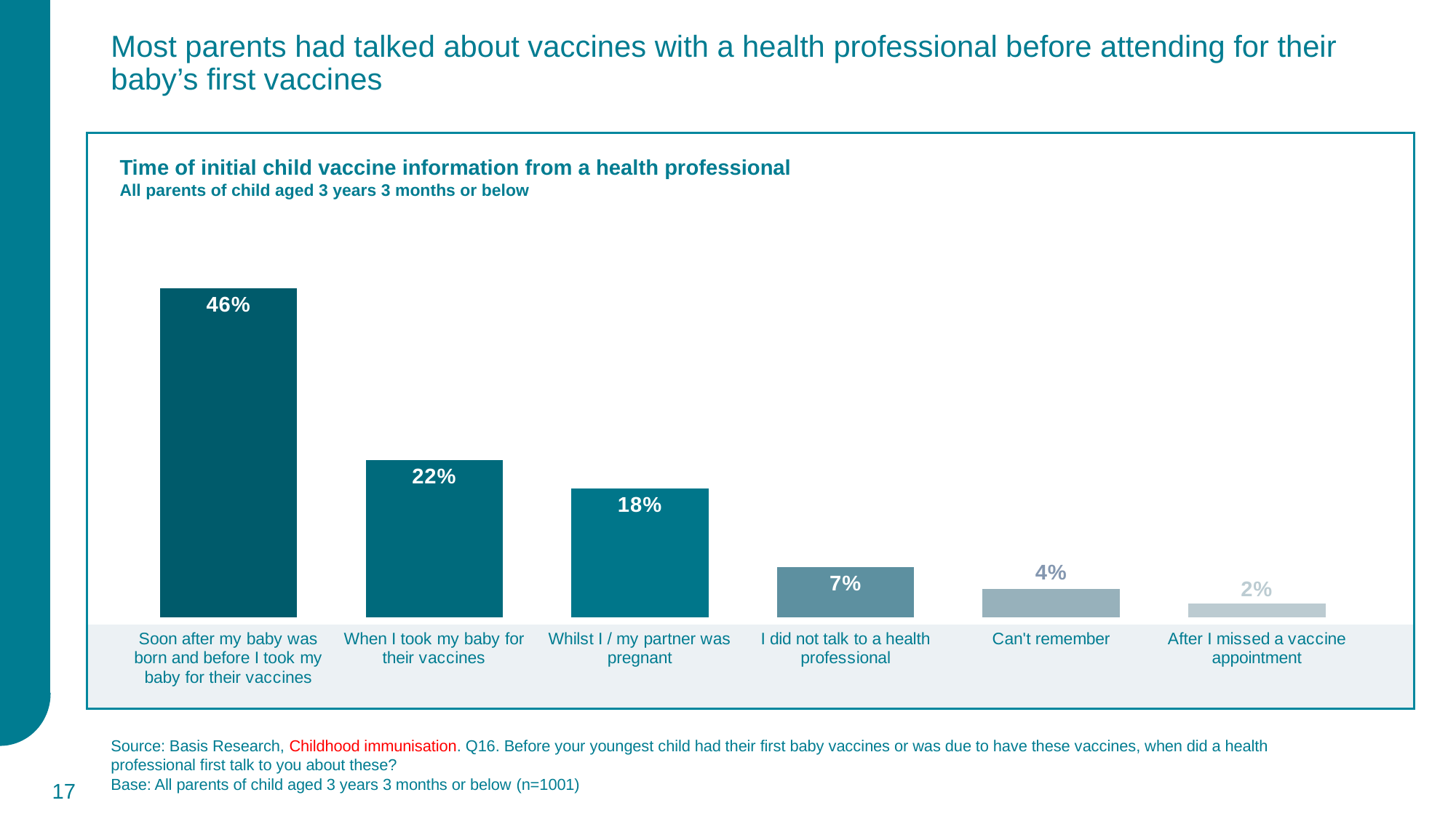
What percentage of parents said they did not talk to a health professional? 7% Which is larger: the value for 'Whilst I / my partner was pregnant' or the value for 'I did not talk to a health professional'? Whilst I / my partner was pregnant What kind of chart is shown on the slide? Bar chart Which category has the lowest value? After I missed a vaccine appointment What is the value for 'Can't remember'? 4% What is the value for 'When I took my baby for their vaccines'? 22% Which category has the highest value? Soon after my baby was born and before I took my baby for their vaccines What is the title of the chart? Time of initial child vaccine information from a health professional Do the values rise or fall moving from left to right across the categories? Fall What is the difference between the value for 'Soon after my baby was born and before I took my baby for their vaccines' and the value for 'When I took my baby for their vaccines'? 24% What percentage of parents first received child vaccine information from a health professional whilst they or their partner was pregnant? 18% How many categories are shown in the chart? 6